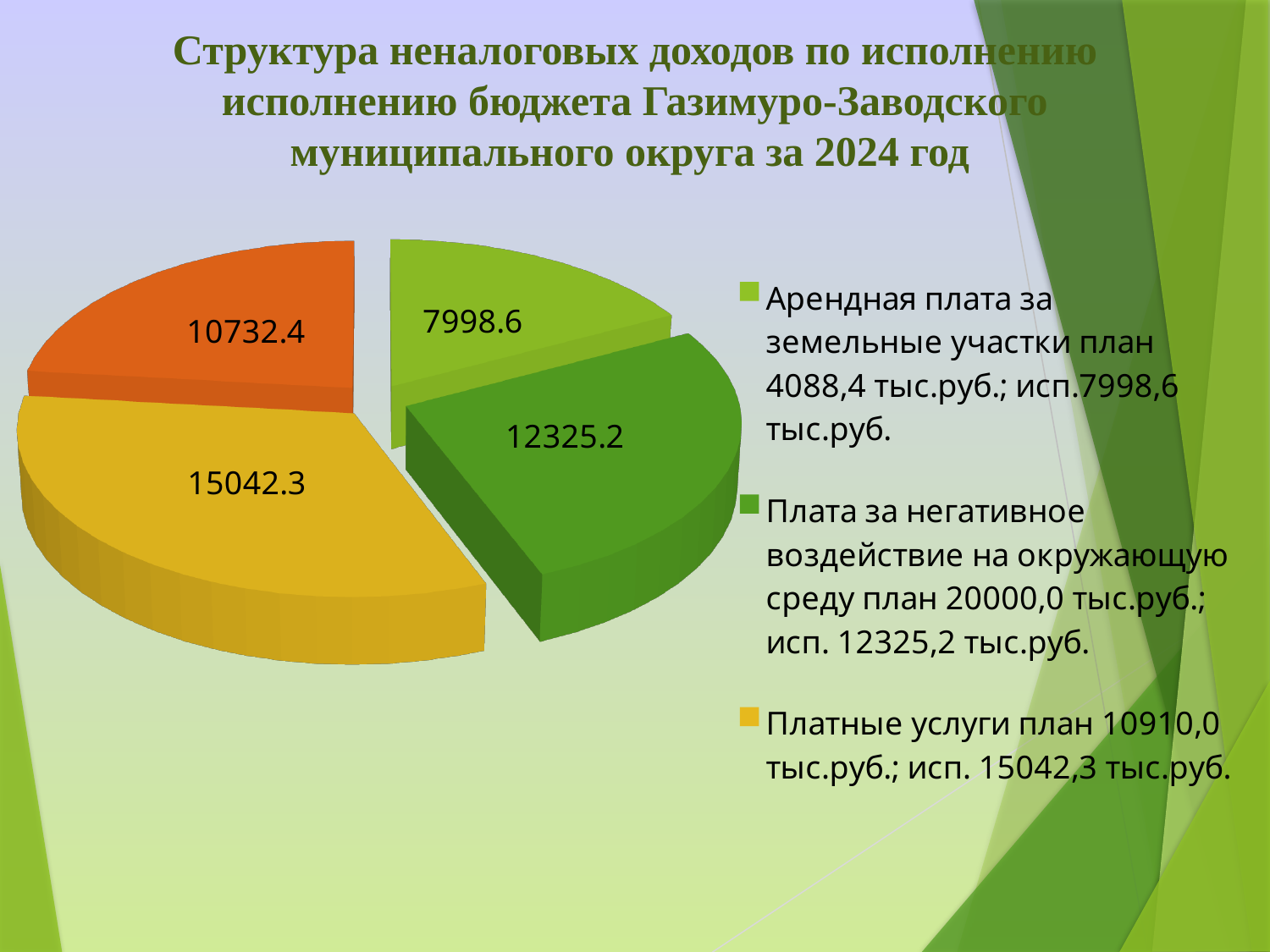
Which slice of the pie chart has the smallest value? Арендная плата за земельные участки (7998.6) How many entries are listed in the legend of the pie chart? 3 Which is larger: the value for "Плата за негативное воздействие на окружающую среду" or the value on the orange slice? Плата за негативное воздействие на окружающую среду (12325.2) What is the difference between the values for "Платные услуги" and "Плата за негативное воздействие на окружающую среду"? 2717.1 What is the value shown for the slice "Платные услуги"? 15042.3 How many slices does the pie chart have? 4 What is the value shown for the slice "Плата за негативное воздействие на окружающую среду"? 12325.2 What is the value shown for the slice "Арендная плата за земельные участки"? 7998.6 What is the value shown on the orange slice of the pie chart? 10732.4 Which slice of the pie chart has the largest value? Платные услуги (15042.3) What colour is the slice for "Платные услуги" in the pie chart? Yellow What type of chart is shown on the slide? Pie chart